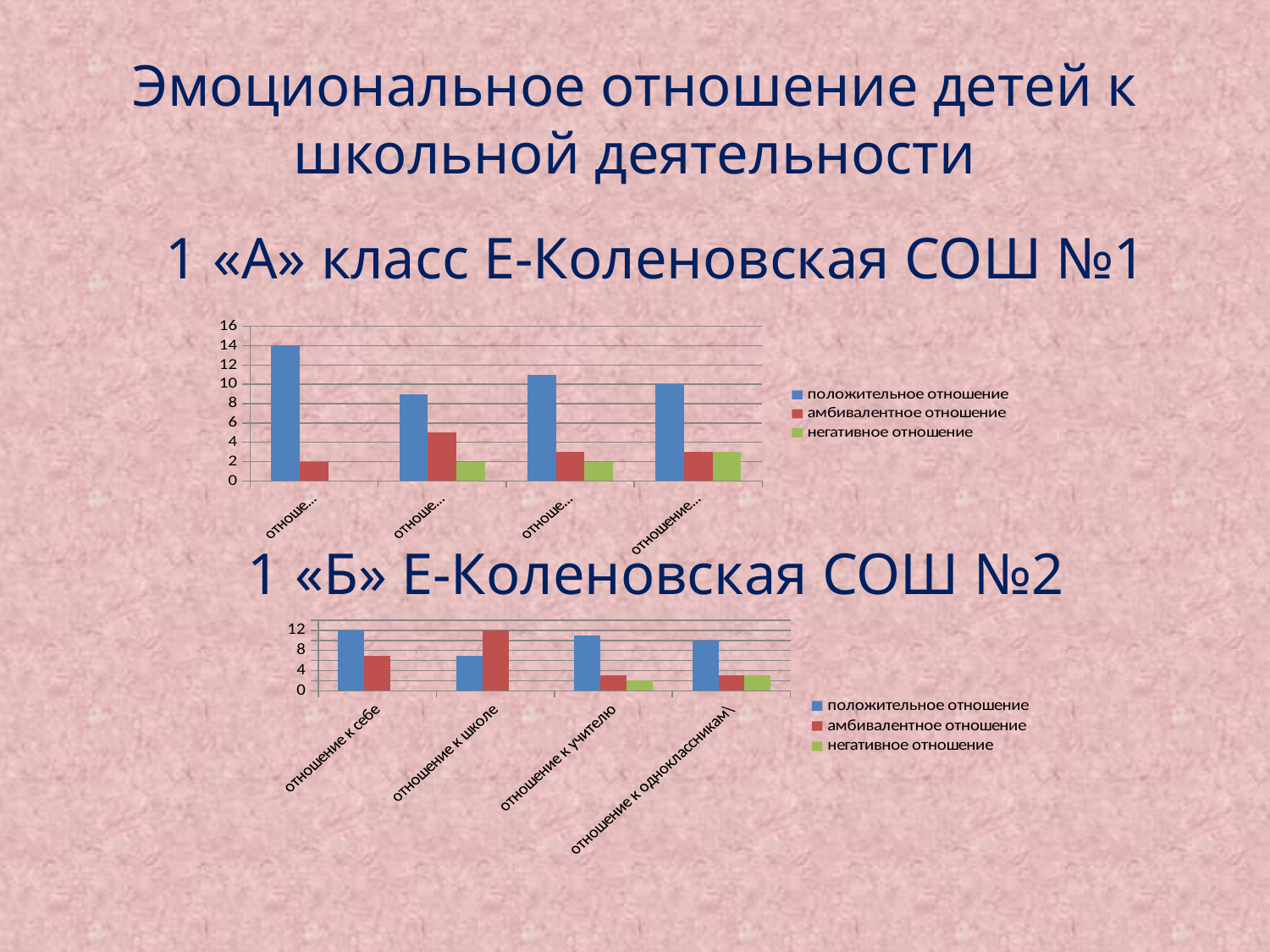
In the top chart (1 «А» класс), what is the value of положительное отношение for the first (leftmost) category? 14 In the bottom chart (1 «Б»), for отношение к школе, which is larger: положительное отношение or амбивалентное отношение? амбивалентное отношение In the bottom chart (1 «Б»), is the value of положительное отношение for отношение к учителю greater or less than 8? greater In the top chart (1 «А» класс), which category has the highest value for положительное отношение? the first (leftmost) category In the top chart (1 «А» класс), is the value of положительное отношение for the second category greater or less than 10? less What kind of chart is the top chart (1 «А» класс Е-Коленовская СОШ №1)? bar chart In the bottom chart (1 «Б»), what is the value of амбивалентное отношение for отношение к школе? 12 In the top chart (1 «А» класс), for the second category, which is larger: амбивалентное отношение or негативное отношение? амбивалентное отношение How many categories are shown on the x axis of the bottom chart (1 «Б» Е-Коленовская СОШ №2)? 4 In the bottom chart (1 «Б»), which category has the lowest value for положительное отношение? отношение к школе How many series does the legend of the top chart (1 «А» класс) list? 3 In the bottom chart (1 «Б»), what is the value of положительное отношение for отношение к себе? 12